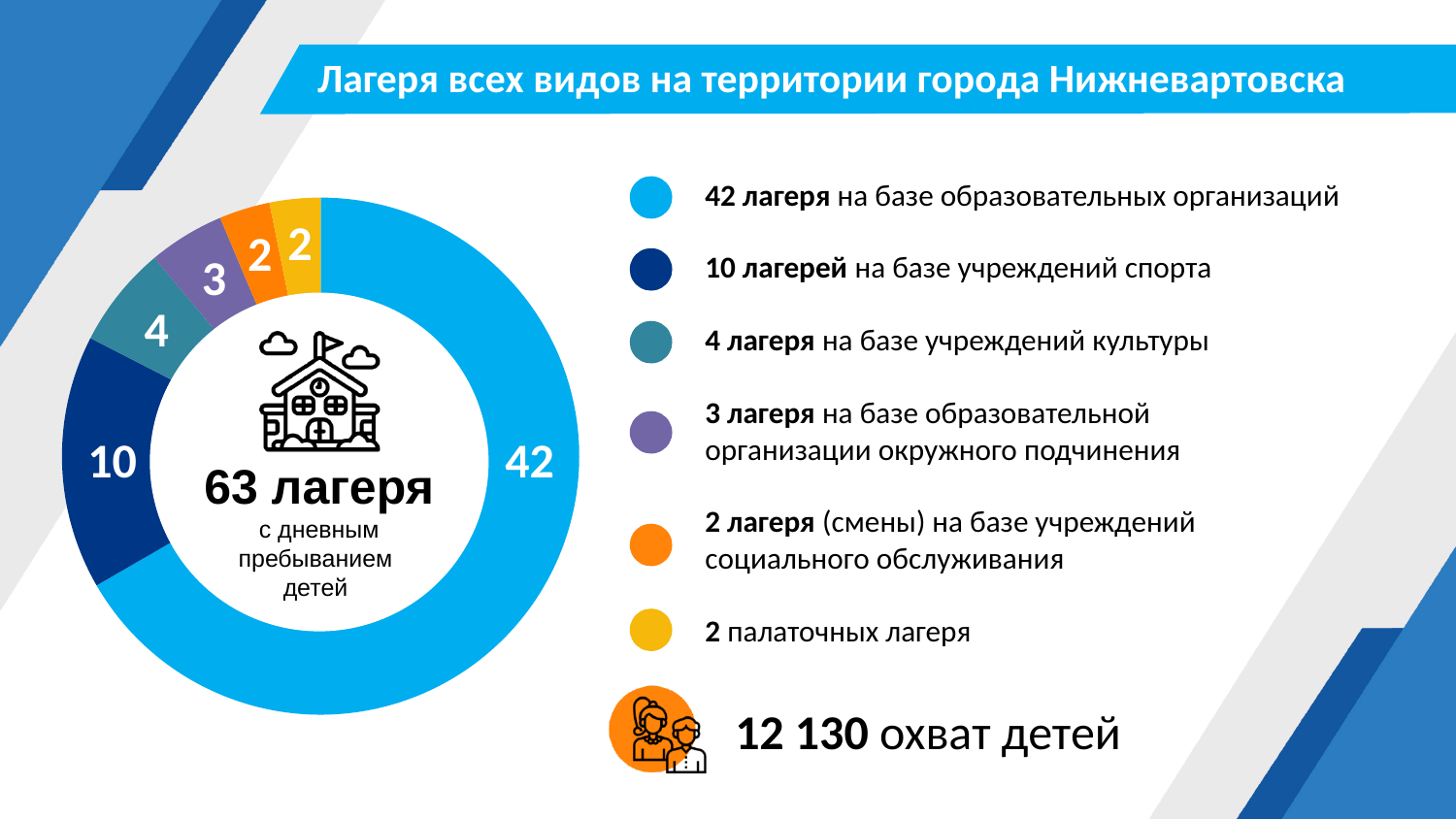
What kind of chart is shown on the slide? Donut (pie) chart What is the title of the slide? Лагеря всех видов на территории города Нижневартовска How many camps are based at sports institutions (на базе учреждений спорта)? 10 What share of the 63 camps are based at educational organisations? Two thirds (42 of 63) How many segments does the donut chart have? 6 How many tent camps (палаточных лагеря) are there? 2 Which is larger: the number of camps at cultural institutions or the number at educational organisations of district subordination? Cultural institutions (4) What is the difference between the number of camps at educational organisations and the number at sports institutions? 32 What is the total number of camps shown in the centre of the donut chart? 63 лагеря How many camps are based at educational organisations (на базе образовательных организаций)? 42 How many camps are based at cultural institutions (на базе учреждений культуры)? 4 Which category has the largest segment in the donut chart? Camps based at educational organisations (42)